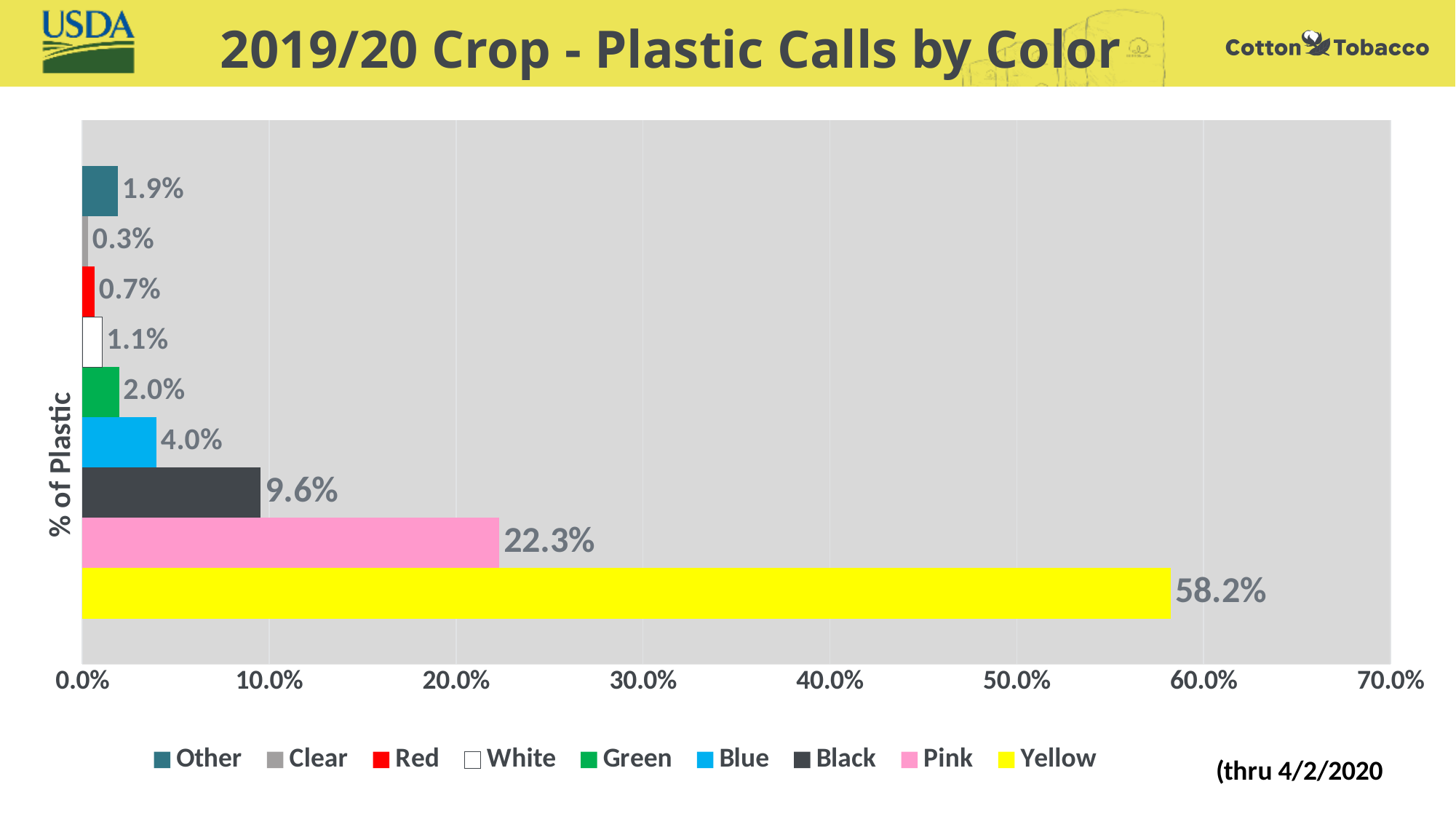
What is the value for Yellow? 58.2% Which color has the highest percentage of plastic calls? Yellow How many colors (series) does the legend list? 9 Which color has the lowest percentage of plastic calls? Clear Is the value for Pink greater or less than 20.0%? greater What is the value for Pink? 22.3% What is the value for Clear? 0.3% What is the title of the chart? 2019/20 Crop - Plastic Calls by Color What is the value for Black? 9.6% What kind of chart is shown on the slide? Bar chart What is the difference between the values for Yellow and Pink? 35.9% Which is larger, the value for Blue or the value for Green? Blue